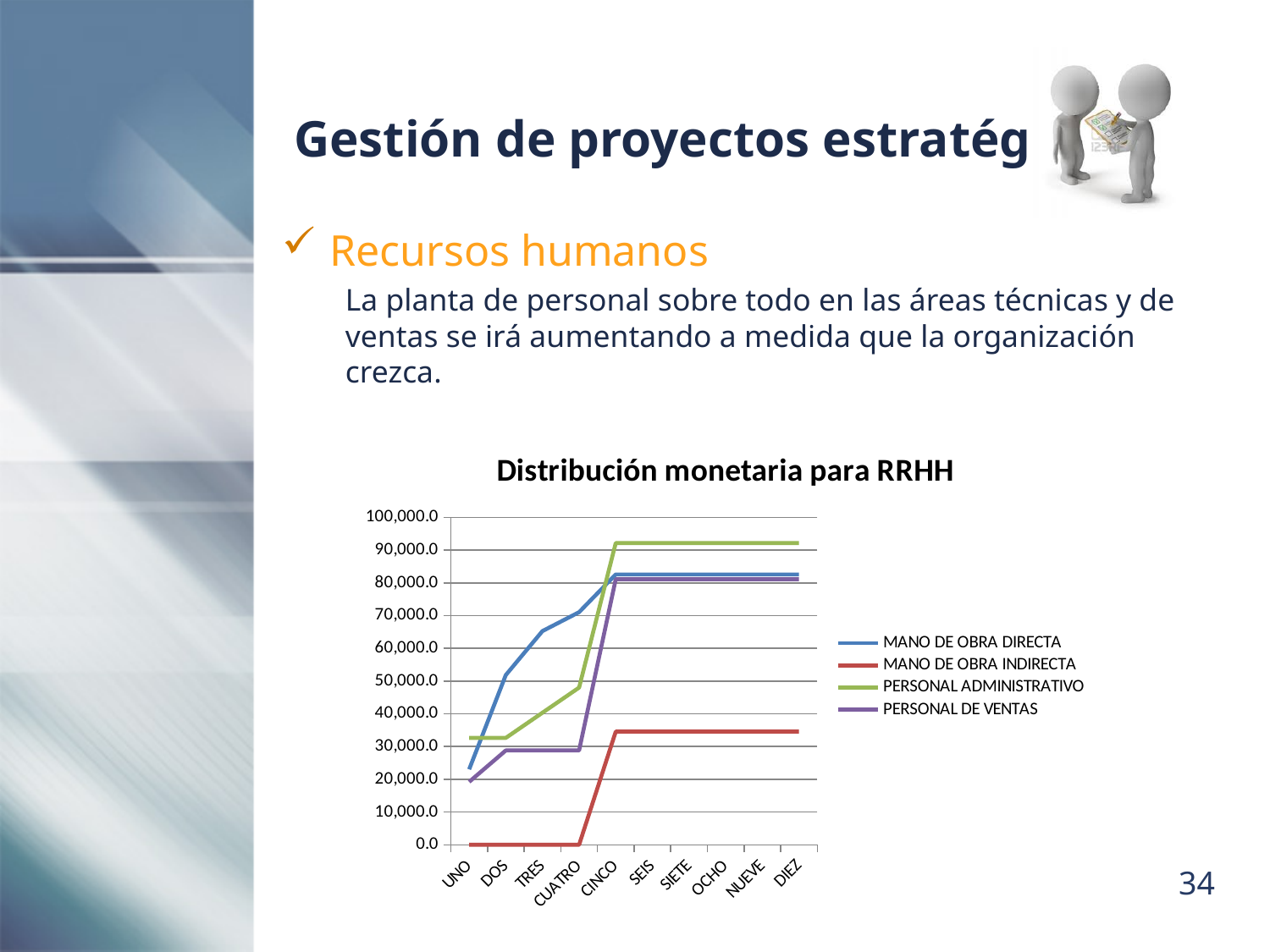
Is the value for PERSONAL ADMINISTRATIVO at DIEZ greater or less than 80,000.0? greater What is the title of the chart? Distribución monetaria para RRHH Which series has the lowest value at DIEZ? MANO DE OBRA INDIRECTA What is the value for MANO DE OBRA INDIRECTA at UNO? 0.0 At DOS, which is larger: MANO DE OBRA DIRECTA or PERSONAL ADMINISTRATIVO? MANO DE OBRA DIRECTA Is the value for MANO DE OBRA INDIRECTA at DIEZ greater or less than 40,000.0? less What kind of chart is shown on the slide? line chart How many series does the chart's legend list? 4 Does the MANO DE OBRA DIRECTA line rise or fall from UNO to CINCO? rise Which series is drawn in red in the chart? MANO DE OBRA INDIRECTA How many categories are shown along the x axis of the chart? 10 Which series has the highest value at DIEZ? PERSONAL ADMINISTRATIVO